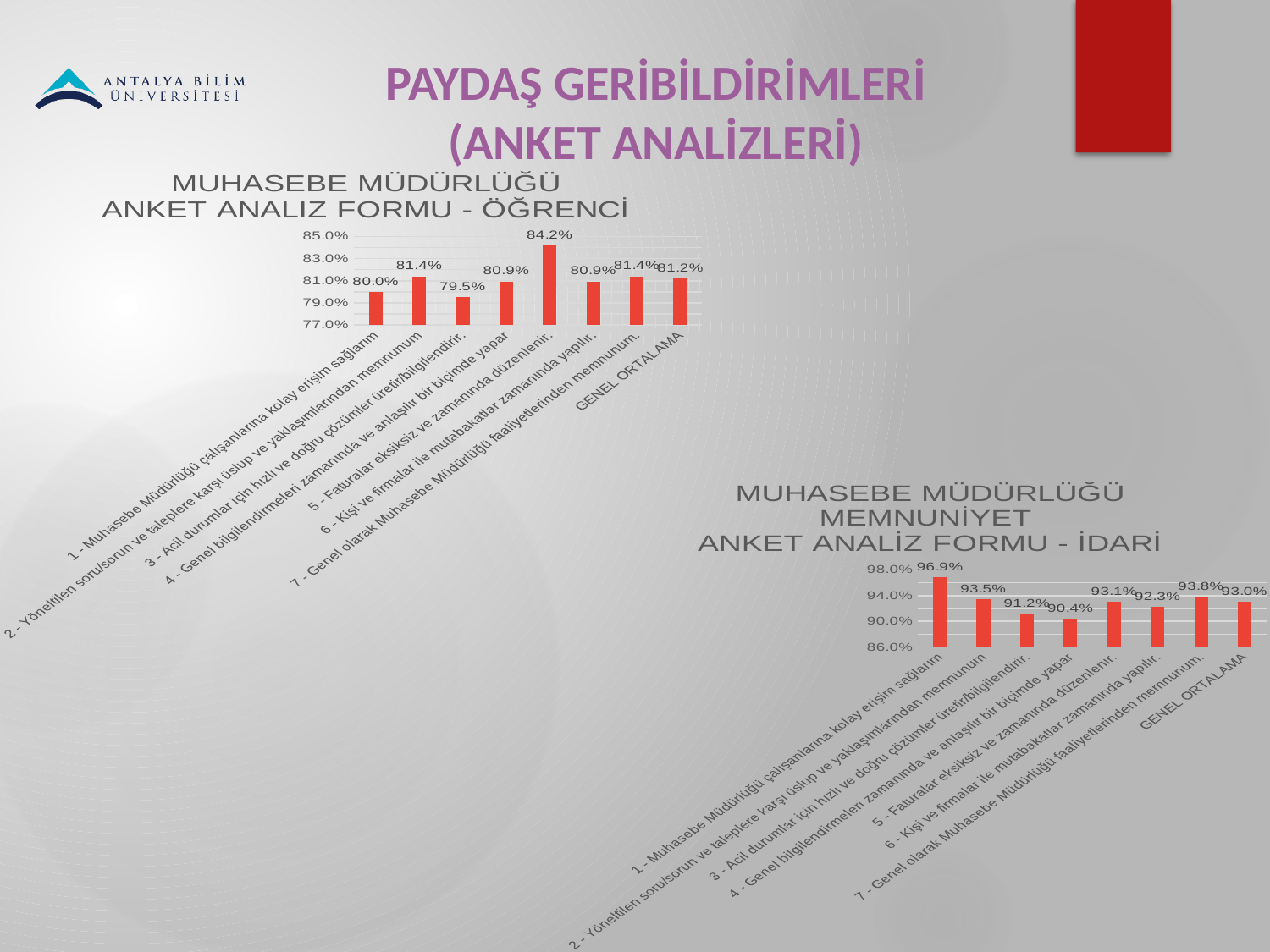
In the İDARİ chart (bottom right), what is the lowest value shown? 90.4% In the İDARİ chart (bottom right), is the value for the first category (1 - Muhasebe Müdürlüğü çalışanlarına kolay erişim sağlarım) greater or less than 94.0%? greater In the İDARİ chart (bottom right), what is the highest value shown? 96.9% In the ÖĞRENCİ chart (top left), what is the value for GENEL ORTALAMA? 81.2% In the İDARİ chart (bottom right), what is the value for GENEL ORTALAMA? 93.0% In the ÖĞRENCİ chart (top left), what is the lowest value shown? 79.5% In the İDARİ chart (bottom right), which is larger: the value for 5 - Faturalar eksiksiz ve zamanında düzenlenir. or the value for 6 - Kişi ve firmalar ile mutabakatlar zamanında yapılır.? 5 - Faturalar eksiksiz ve zamanında düzenlenir. How many charts are shown on the slide? 2 What type of chart is the İDARİ chart (bottom right)? Bar chart In the ÖĞRENCİ chart (top left), how many bars are plotted? 8 In the ÖĞRENCİ chart (top left), what is the difference between the highest value (84.2%) and the lowest value (79.5%)? 4.7% In the ÖĞRENCİ chart (top left), which category has the highest value? 5 - Faturalar eksiksiz ve zamanında düzenlenir.